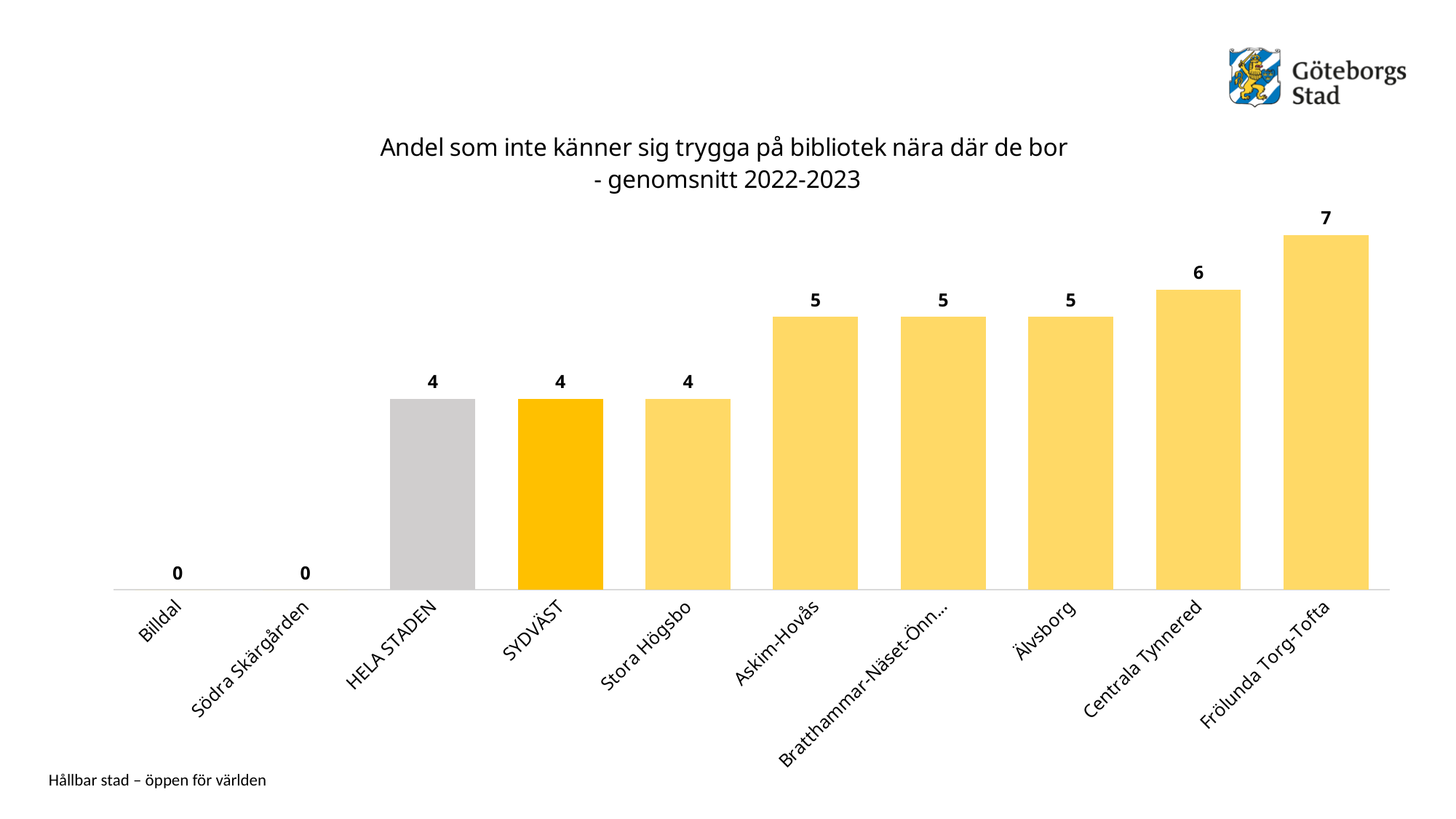
Which category has the highest value? Frölunda Torg-Tofta What is the value for HELA STADEN? 4 What is the value for Centrala Tynnered? 6 Which is larger, the value for Askim-Hovås or the value for Stora Högsbo? Askim-Hovås What is the value for Billdal? 0 What kind of chart is shown on the slide? Bar chart What is the value for Frölunda Torg-Tofta? 7 Do the values generally rise or fall from left to right along the x axis? Rise Which bar is coloured grey? HELA STADEN What is the difference between the values for Frölunda Torg-Tofta and SYDVÄST? 3 How many categories are shown on the x axis? 10 What is the difference between the values for Centrala Tynnered and Älvsborg? 1